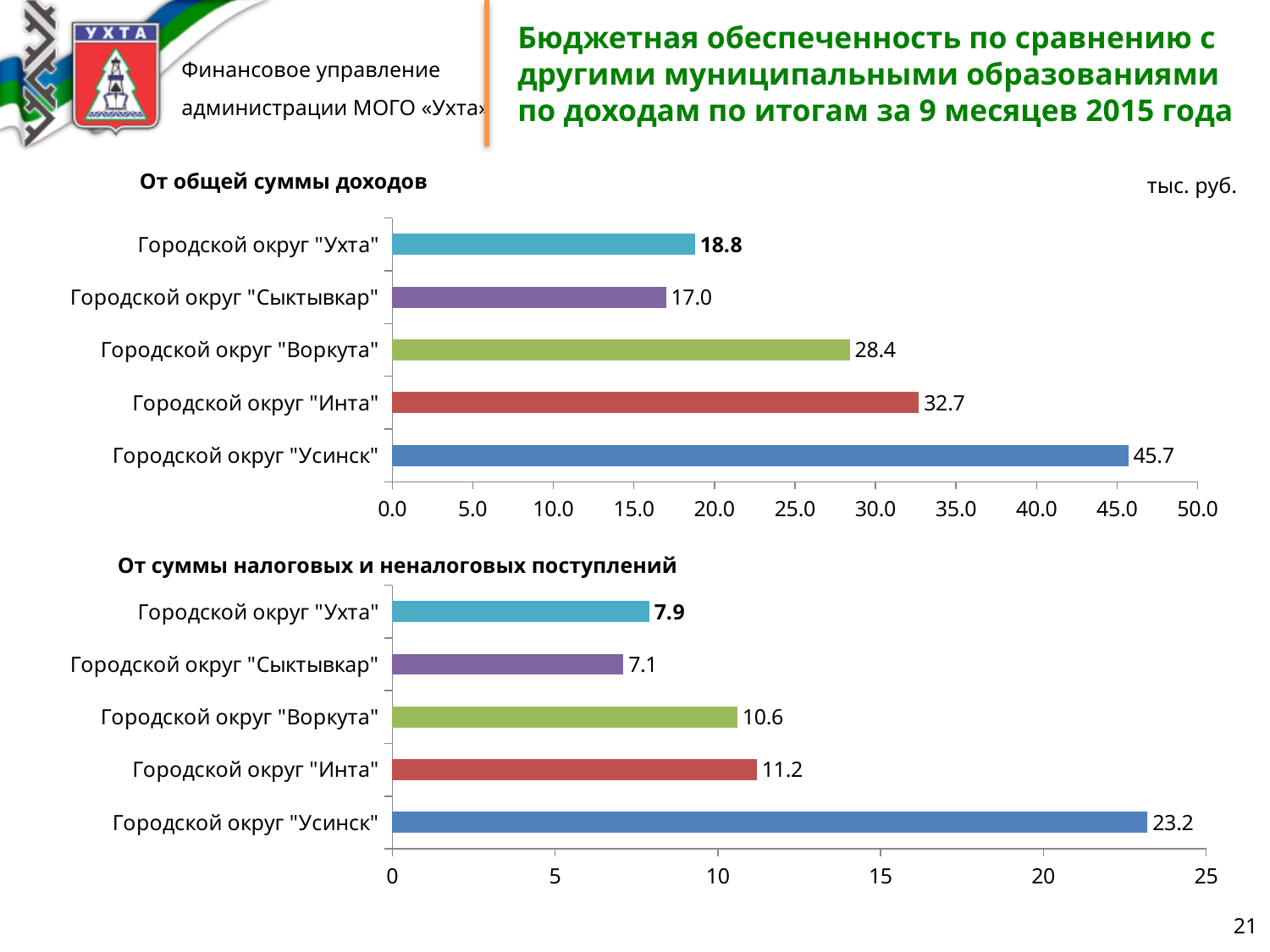
In the chart "От суммы налоговых и неналоговых поступлений", what is the difference between Городской округ "Ухта" and Городской округ "Сыктывкар"? 0.8 What unit is indicated at the top right of the charts? тыс. руб. In the chart "От общей суммы доходов", how many categories are shown? 5 In the chart "От общей суммы доходов", what is the difference between Городской округ "Усинск" and Городской округ "Инта"? 13.0 In the chart "От общей суммы доходов", which category has the lowest value? Городской округ "Сыктывкар" In the chart "От суммы налоговых и неналоговых поступлений", which category has the highest value? Городской округ "Усинск" In the chart "От суммы налоговых и неналоговых поступлений", which is larger: Городской округ "Инта" or Городской округ "Ухта"? Городской округ "Инта" In the chart "От общей суммы доходов", what is the value for Городской округ "Ухта"? 18.8 In the chart "От суммы налоговых и неналоговых поступлений", what is the value for Городской округ "Воркута"? 10.6 In the chart "От суммы налоговых и неналоговых поступлений", which category has the lowest value? Городской округ "Сыктывкар" What type of chart is the chart "От общей суммы доходов"? Bar chart In the chart "От общей суммы доходов", which category has the highest value? Городской округ "Усинск"